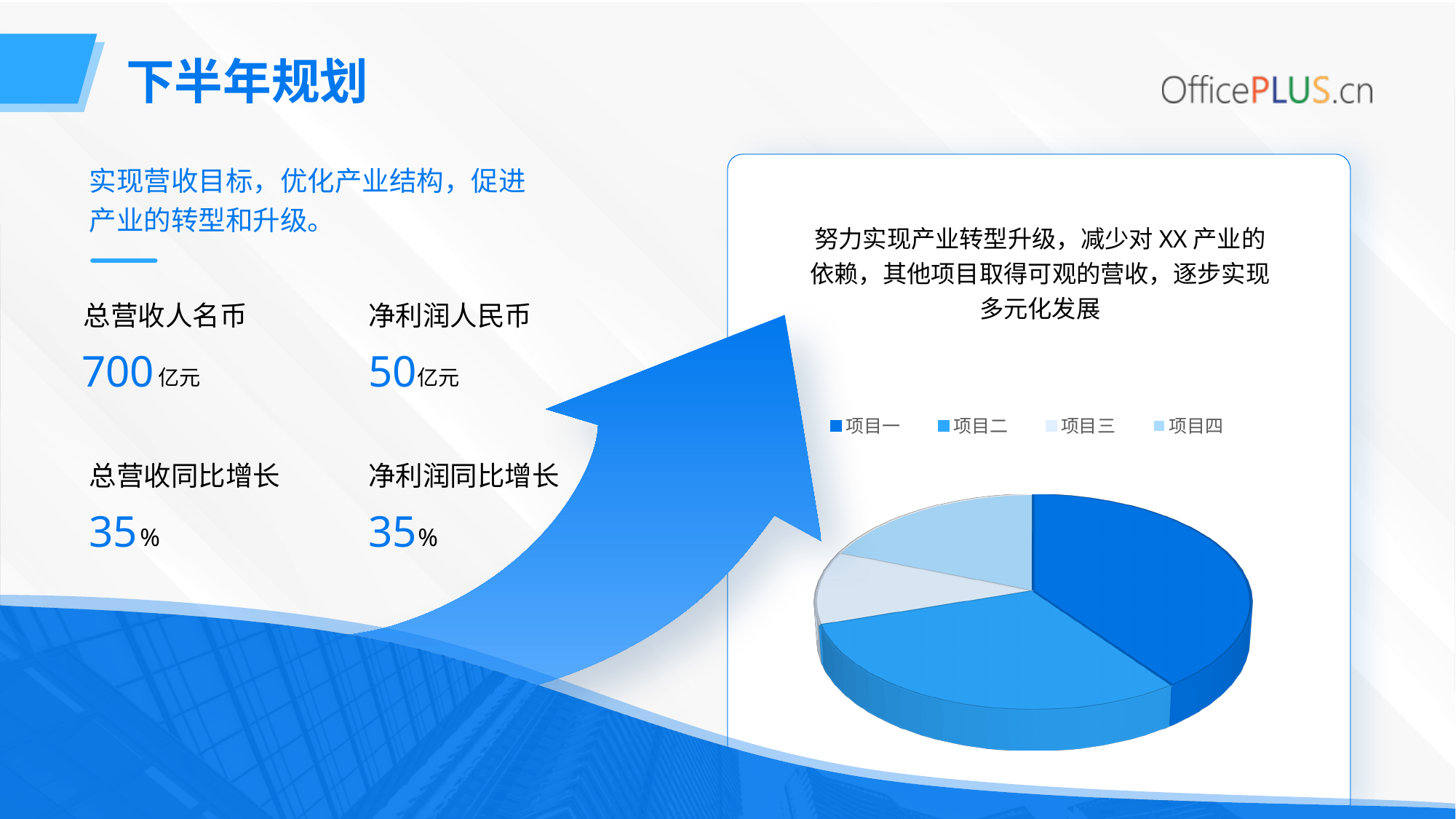
What kind of chart is shown on the slide? Pie chart Which category has the largest slice in the pie chart? 项目一 Which slice is larger, 项目一 or 项目三? 项目一 Which slice is larger, 项目二 or 项目三? 项目二 What is the first entry listed in the chart's legend? 项目一 Which slice is larger, 项目一 or 项目二? 项目一 How many slices does the pie chart have? 4 What is the last entry listed in the chart's legend? 项目四 How many entries does the chart's legend list? 4